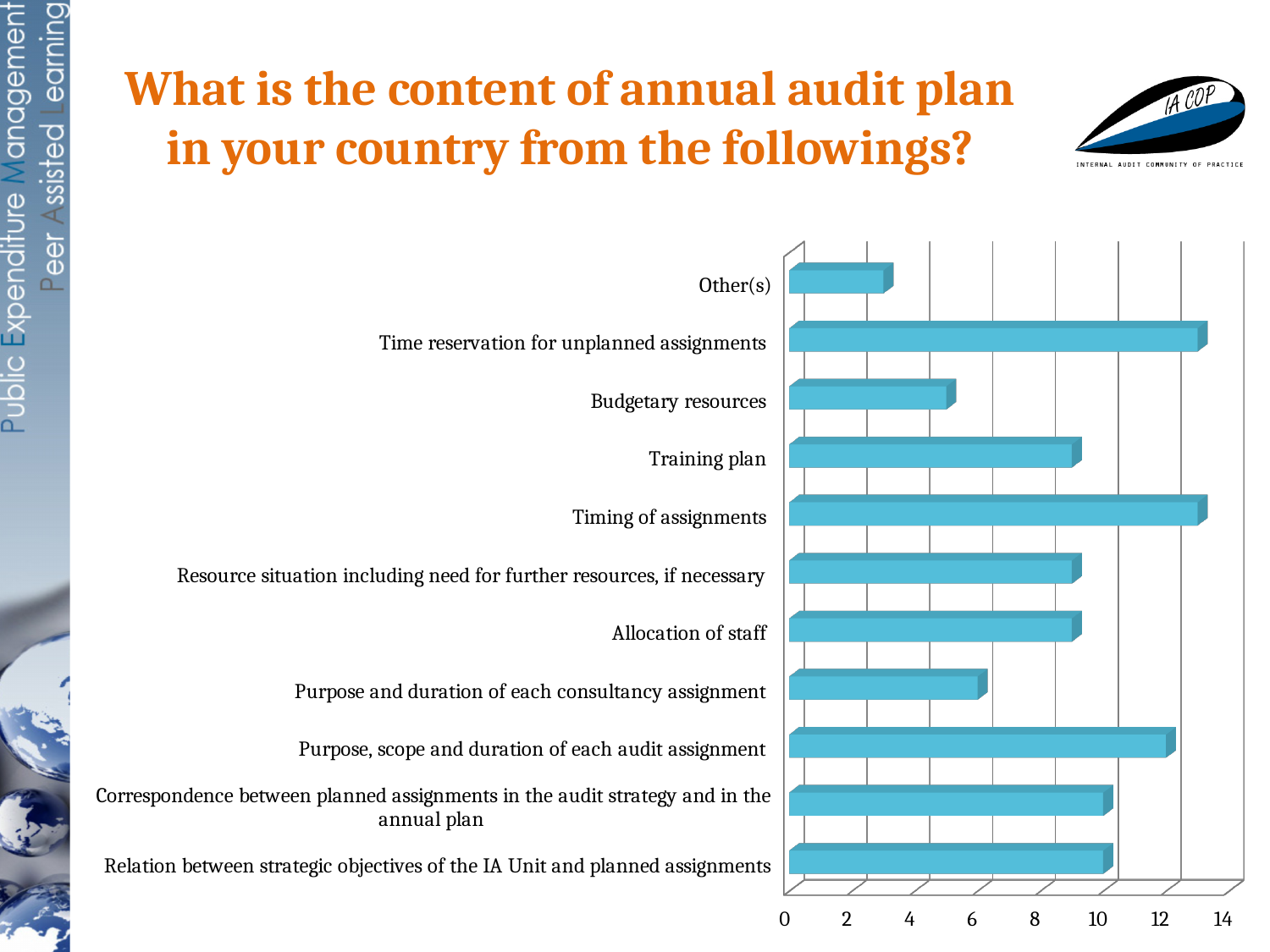
Which category has the lowest value in the chart? Other(s) What is the highest value shown on the horizontal axis of the chart? 14 Is the value for Budgetary resources greater or less than 6? less Is the value for Time reservation for unplanned assignments greater or less than 12? greater What kind of chart is shown on the slide? bar chart How many categories are plotted in the chart? 11 Is the value for Other(s) greater or less than 4? less Which is larger: the value for Allocation of staff or the value for Other(s)? Allocation of staff Which is larger: the value for Purpose, scope and duration of each audit assignment or the value for Purpose and duration of each consultancy assignment? Purpose, scope and duration of each audit assignment Which is larger: the value for Timing of assignments or the value for Budgetary resources? Timing of assignments